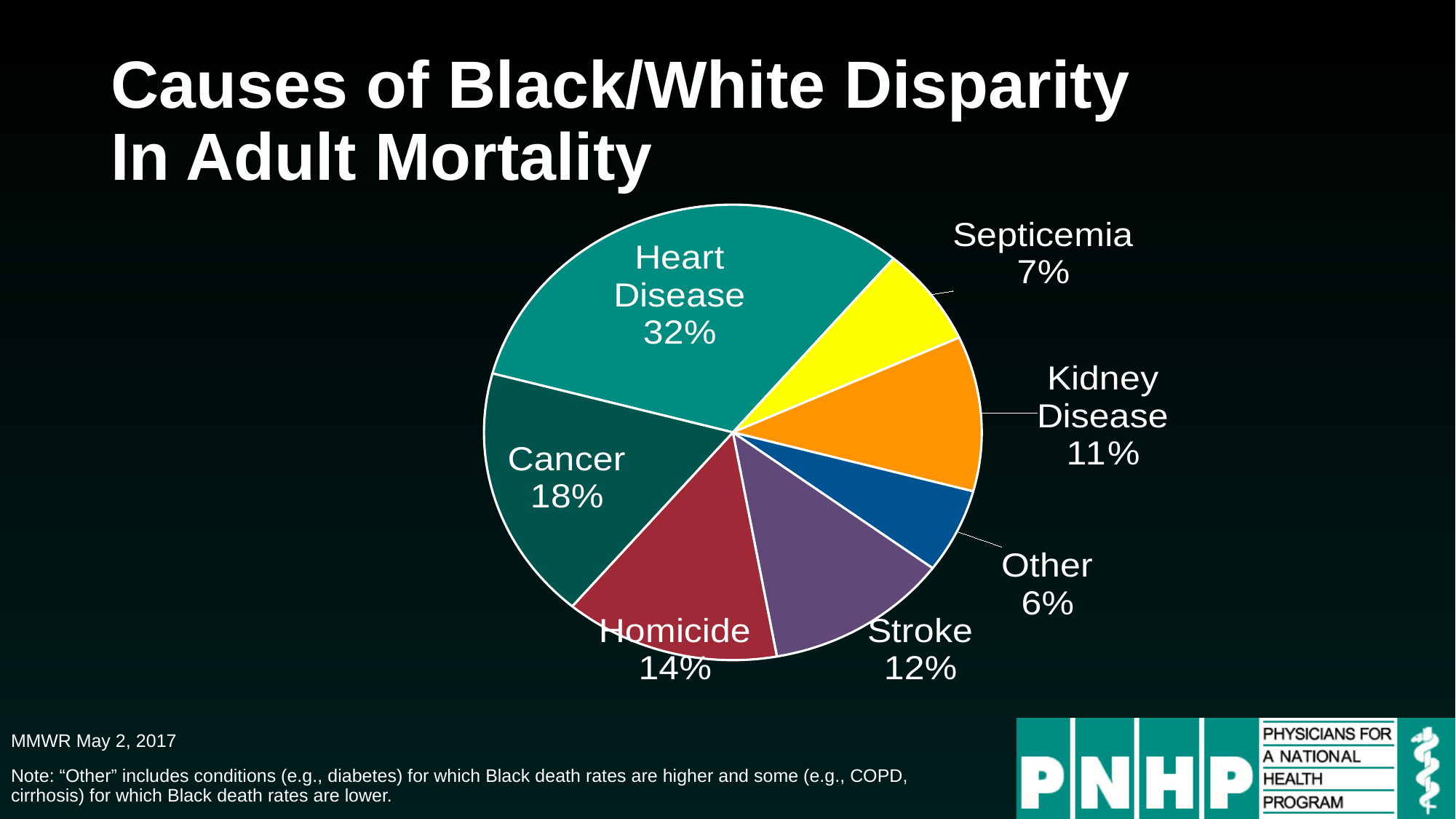
Which is larger, the share for Stroke or the share for Kidney Disease? Stroke What is the title of the slide containing the chart? Causes of Black/White Disparity In Adult Mortality What kind of chart is shown on the slide? Pie chart Which cause has the smallest slice of the pie? Other What is the difference between the Homicide and Stroke shares? 2% What is the difference between the Heart Disease and Cancer shares? 14% What is the value shown for Septicemia? 7% What is the value shown for Cancer? 18% What is the value shown for Kidney Disease? 11% What share of the pie does Heart Disease account for? 32% Which cause has the largest slice of the pie? Heart Disease How many slices does the pie chart have? 7